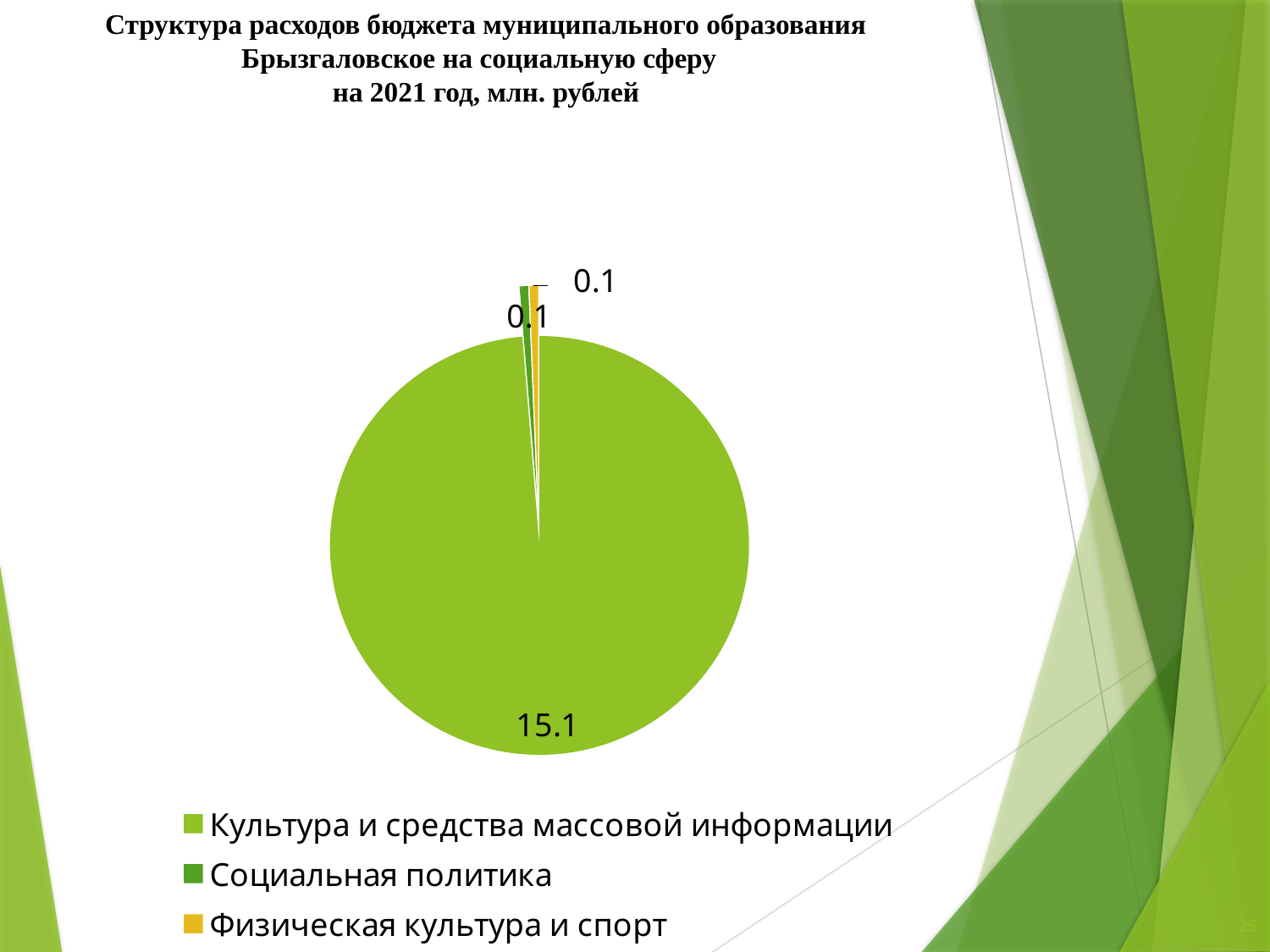
What value is shown for Культура и средства массовой информации? 15.1 What is the total of all the values shown on the pie chart? 15.3 Which legend entry is marked with a yellow/orange colour? Физическая культура и спорт How many slices does the pie chart have? 3 Which is larger: the value for Культура и средства массовой информации or the value for Физическая культура и спорт? Культура и средства массовой информации Which category has the largest slice of the pie? Культура и средства массовой информации What value is shown for Физическая культура и спорт? 0.1 What kind of chart is shown on the slide? Pie chart What is the difference between the values for Культура и средства массовой информации and Социальная политика? 15.0 What unit of measurement is stated in the chart title? млн. рублей How many entries does the legend list? 3 What value is shown for Социальная политика? 0.1